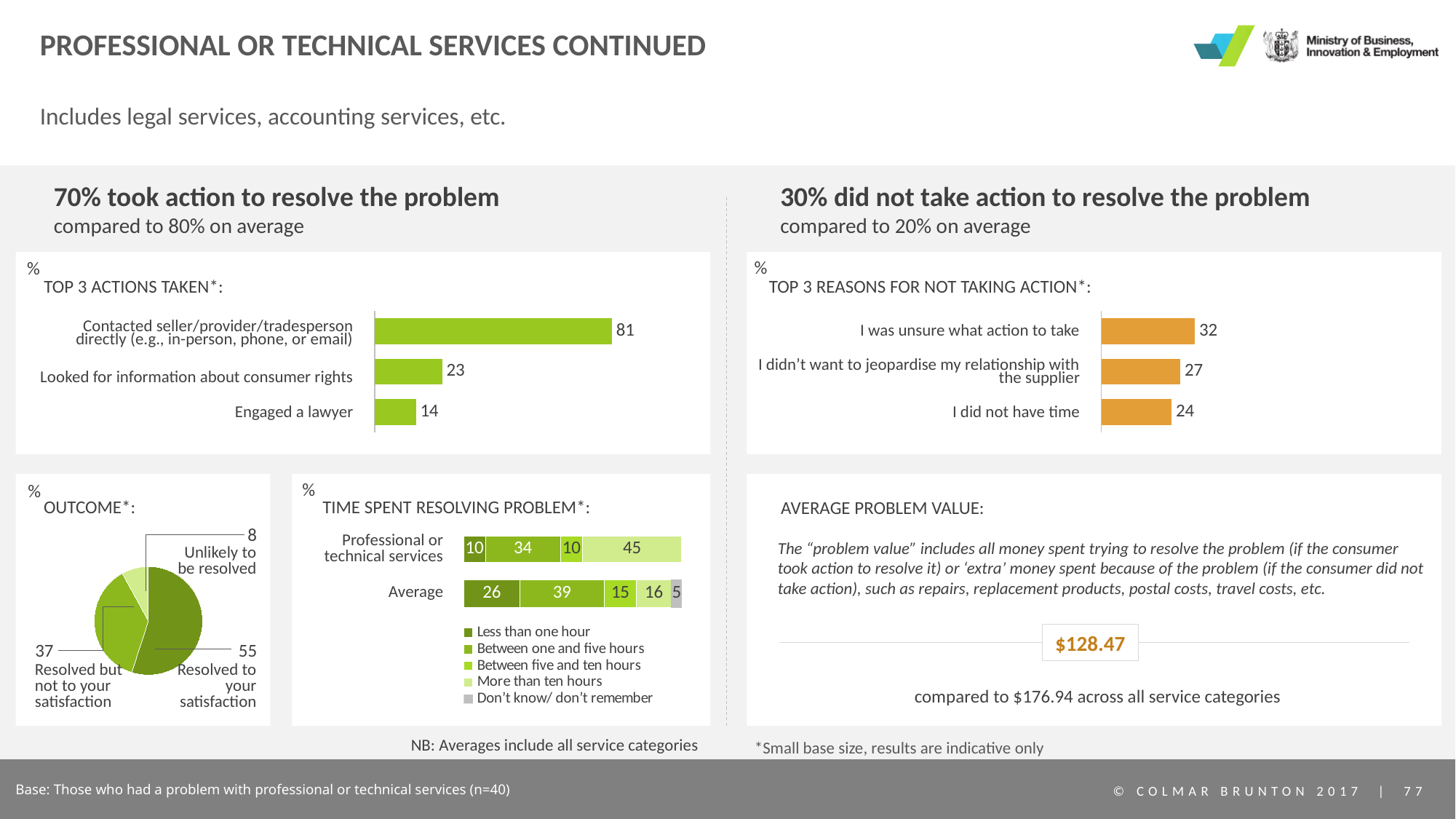
In the 'Top 3 actions taken' chart, which action has the highest value? Contacted seller/provider/tradesperson directly (e.g., in-person, phone, or email) In the 'Top 3 actions taken' chart, what is the difference between 'Contacted seller/provider/tradesperson directly' and 'Looked for information about consumer rights'? 58 In the 'Outcome' pie chart, what share is 'Resolved to your satisfaction'? 55 In the 'Top 3 reasons for not taking action' chart, which reason has the lowest value? I did not have time In the 'Time spent resolving problem' chart, what is the difference between the 'Less than one hour' values for Average and Professional or technical services? 16 In the 'Time spent resolving problem' chart, what is the value for 'More than ten hours' for Professional or technical services? 45 In the 'Top 3 reasons for not taking action' chart, what is the value for 'I did not have time'? 24 In the 'Top 3 actions taken' chart, what is the value for 'Engaged a lawyer'? 14 How many series does the legend of the 'Time spent resolving problem' chart list? 5 What kind of chart is the 'Outcome' chart? Pie chart In the 'Top 3 reasons for not taking action' chart, which is larger: 'I was unsure what action to take' or 'I didn't want to jeopardise my relationship with the supplier'? I was unsure what action to take In the 'Outcome' pie chart, what is the value for 'Unlikely to be resolved'? 8